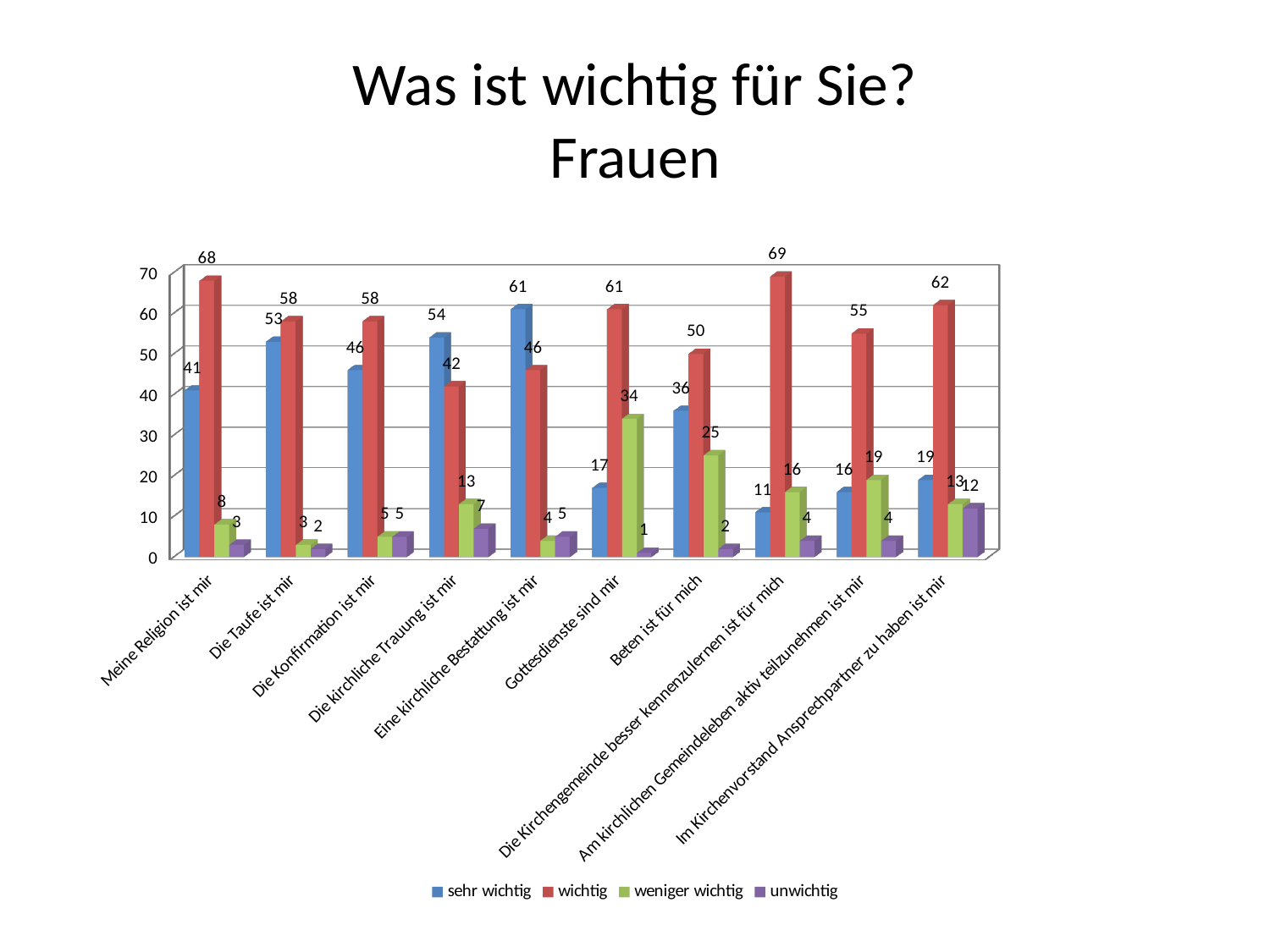
What is the value of "wichtig" for "Meine Religion ist mir"? 68 What is the title of the slide? Was ist wichtig für Sie? Frauen How many categories are shown on the x axis? 10 Which category has the lowest "sehr wichtig" value? Die Kirchengemeinde besser kennenzulernen ist für mich For "Die kirchliche Trauung ist mir", which is larger: "sehr wichtig" or "wichtig"? sehr wichtig What is the value of "unwichtig" for "Im Kirchenvorstand Ansprechpartner zu haben ist mir"? 12 What is the value of "weniger wichtig" for "Gottesdienste sind mir"? 34 What is the value of "sehr wichtig" for "Eine kirchliche Bestattung ist mir"? 61 What kind of chart is shown on the slide? bar chart What is the difference between the "wichtig" and "sehr wichtig" values for "Gottesdienste sind mir"? 44 How many series does the legend list? 4 Which category has the highest "wichtig" value? Die Kirchengemeinde besser kennenzulernen ist für mich